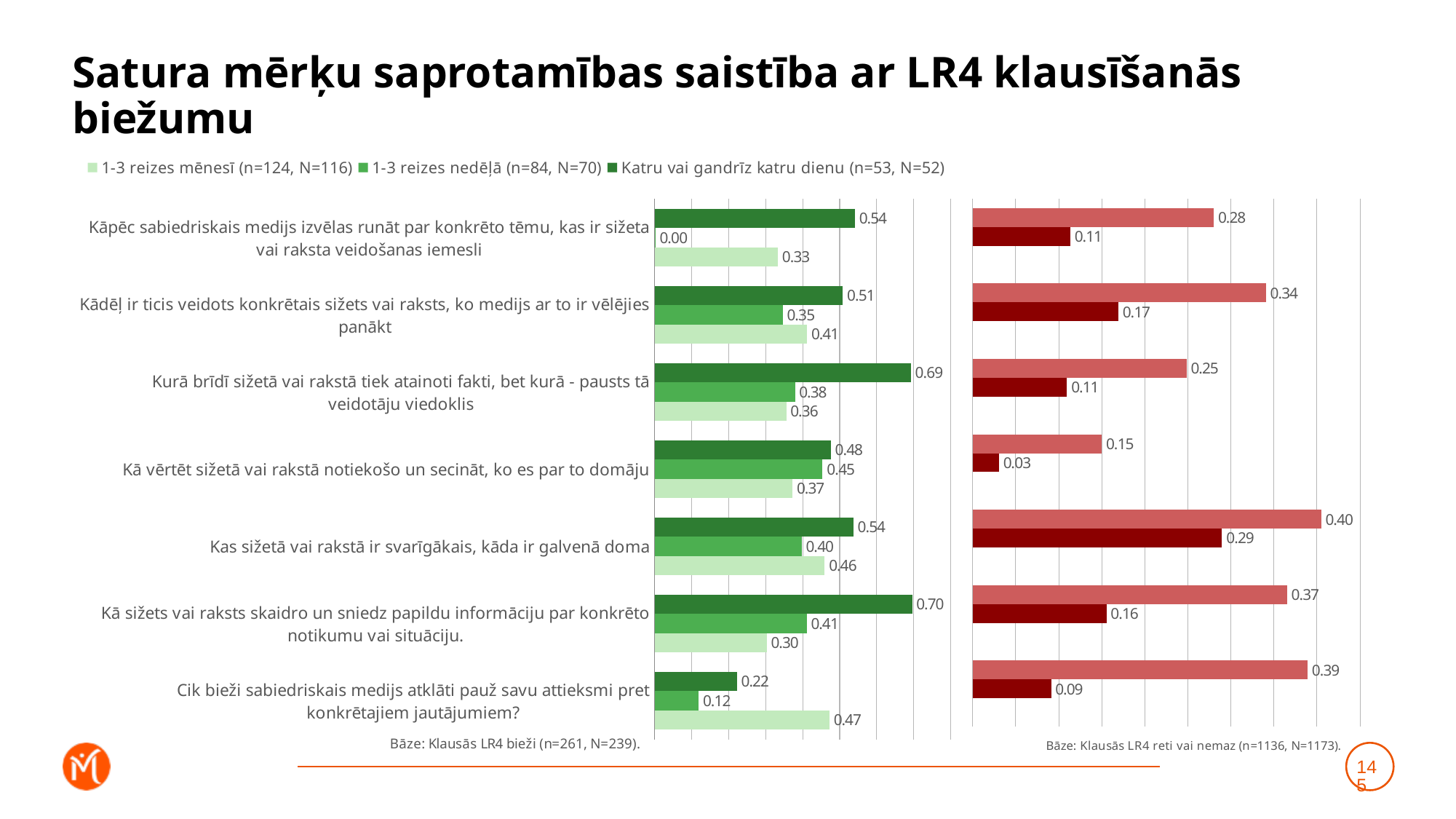
What base note is printed under the right (red) chart? Bāze: Klausās LR4 reti vai nemaz (n=1136, N=1173). In the left (green) chart, what is the value for '1-3 reizes mēnesī' for the category 'Cik bieži sabiedriskais medijs atklāti pauž savu attieksmi pret konkrētajiem jautājumiem?'? 0.47 In the left (green) chart, what is the value for 'Katru vai gandrīz katru dienu' for the category 'Kurā brīdī sižetā vai rakstā tiek atainoti fakti, bet kurā - pausts tā veidotāju viedoklis'? 0.69 In the left (green) chart, for 'Kas sižetā vai rakstā ir svarīgākais, kāda ir galvenā doma', which is larger: '1-3 reizes mēnesī' or '1-3 reizes nedēļā'? 1-3 reizes mēnesī In the right (red) chart, which category has the highest value for the darker red bars? Kas sižetā vai rakstā ir svarīgākais, kāda ir galvenā doma How many series does the legend of the left (green) chart list? 3 What type of chart is the left (green) chart? Bar chart In the left (green) chart, for 'Kā sižets vai raksts skaidro un sniedz papildu informāciju par konkrēto notikumu vai situāciju.', what is the difference between 'Katru vai gandrīz katru dienu' and '1-3 reizes mēnesī'? 0.40 In the left (green) chart, which category has the lowest value for '1-3 reizes nedēļā'? Kāpēc sabiedriskais medijs izvēlas runāt par konkrēto tēmu, kas ir sižeta vai raksta veidošanas iemesli In the left (green) chart, which category has the highest value for 'Katru vai gandrīz katru dienu'? Kā sižets vai raksts skaidro un sniedz papildu informāciju par konkrēto notikumu vai situāciju. In the right (red) chart, what is the value of the lighter red bar for 'Kas sižetā vai rakstā ir svarīgākais, kāda ir galvenā doma'? 0.40 How many categories are shown in the left (green) chart? 7